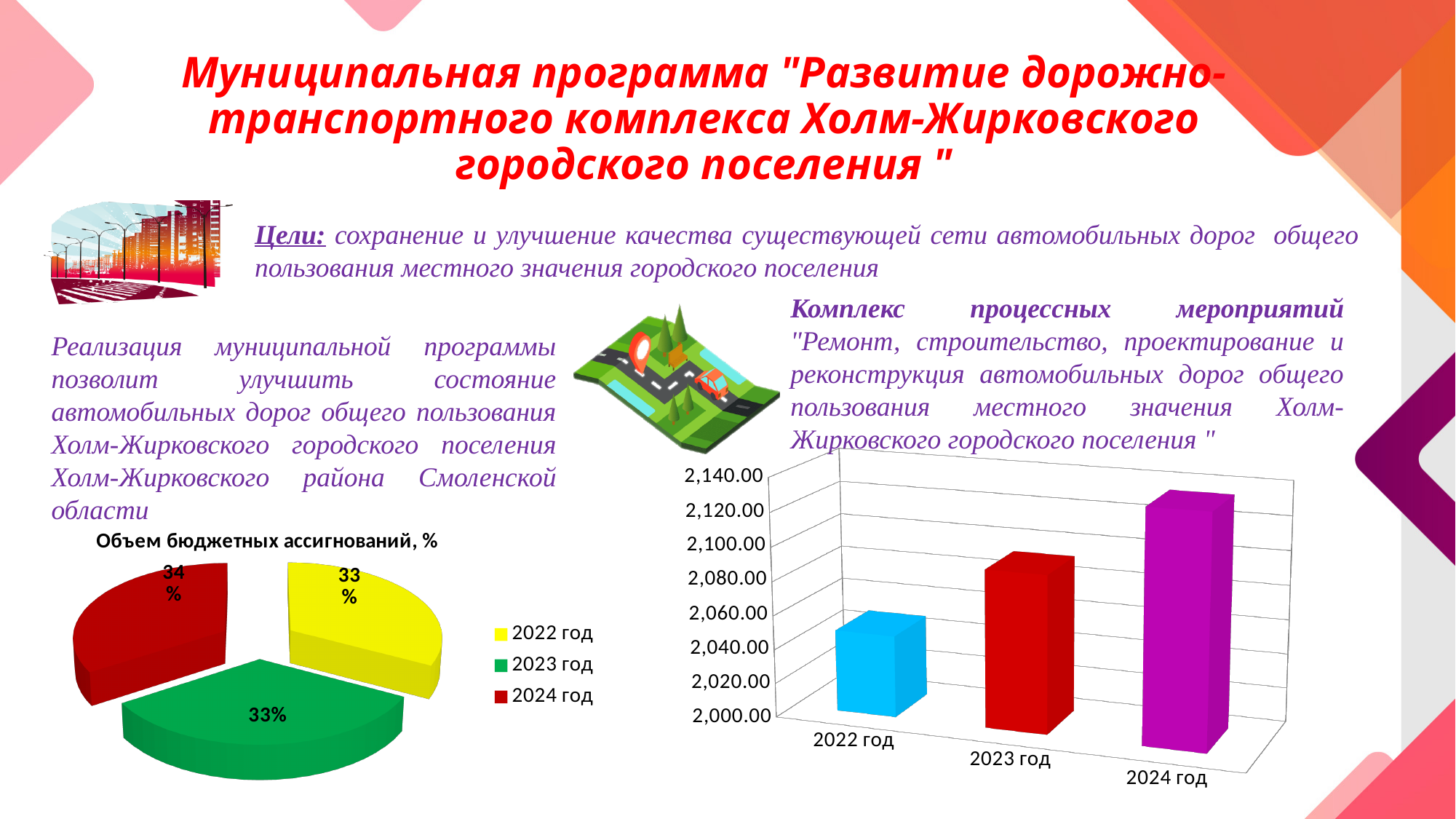
In the pie chart 'Объем бюджетных ассигнований, %', what is the share for 2024 год? 34% In the pie chart 'Объем бюджетных ассигнований, %', which year has the largest share? 2024 год In the pie chart 'Объем бюджетных ассигнований, %', what is the difference between the shares for 2024 год and 2023 год? 1% In the pie chart 'Объем бюджетных ассигнований, %', what is the share for 2022 год? 33% In the bar chart on the right, do the values rise or fall from 2022 год to 2024 год? Rise In the pie chart 'Объем бюджетных ассигнований, %', how many slices are there? 3 In the bar chart on the right, how many bars are there? 3 In the bar chart on the right, is the value for 2024 год greater or less than 2,100.00? greater In the pie chart 'Объем бюджетных ассигнований, %', which colour represents 2023 год? Green In the bar chart on the right, is the value for 2022 год greater or less than 2,080.00? less What kind of chart is the chart on the right side of the slide? Bar chart In the bar chart on the right, which year has the highest bar? 2024 год